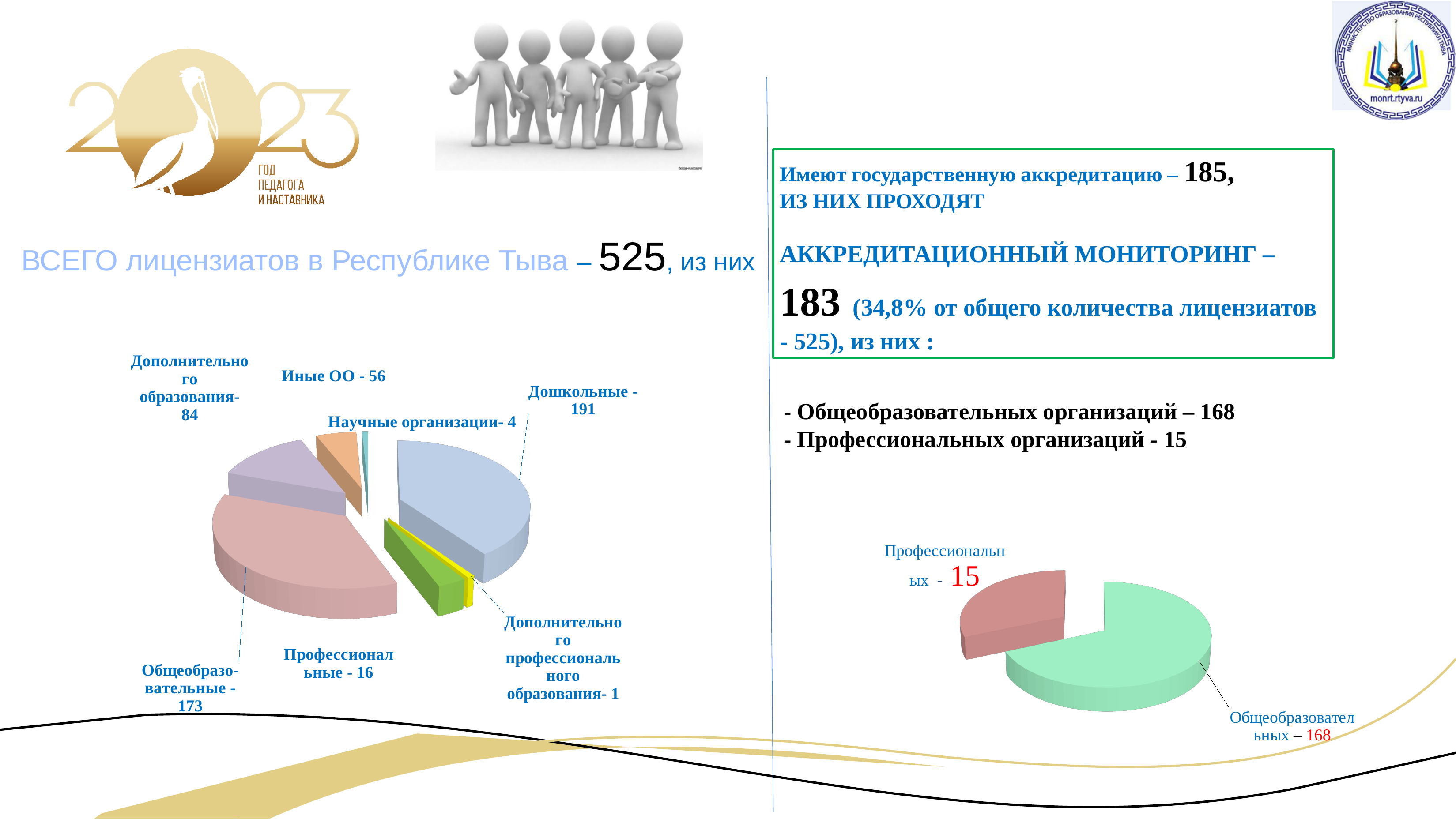
On the left pie chart, what is the value for Дошкольные? 191 On the right pie chart, what is the total of the two slices? 183 On the left pie chart, which is larger: Дополнительного образования or Иные ОО? Дополнительного образования On the left pie chart, which category has the smallest value? Дополнительного профессионального образования On the left pie chart, what is the value for Иные ОО? 56 On the left pie chart, which category has the largest value? Дошкольные On the right pie chart, what is the difference between Общеобразовательных and Профессиональных? 153 On the right pie chart, what is the value for Общеобразовательных? 168 How many categories does the left pie chart show? 7 What type of chart is the chart on the left of the slide? Pie chart On the left pie chart, what is the value for Научные организации? 4 On the left pie chart, what is the difference between Дошкольные and Общеобразовательные? 18